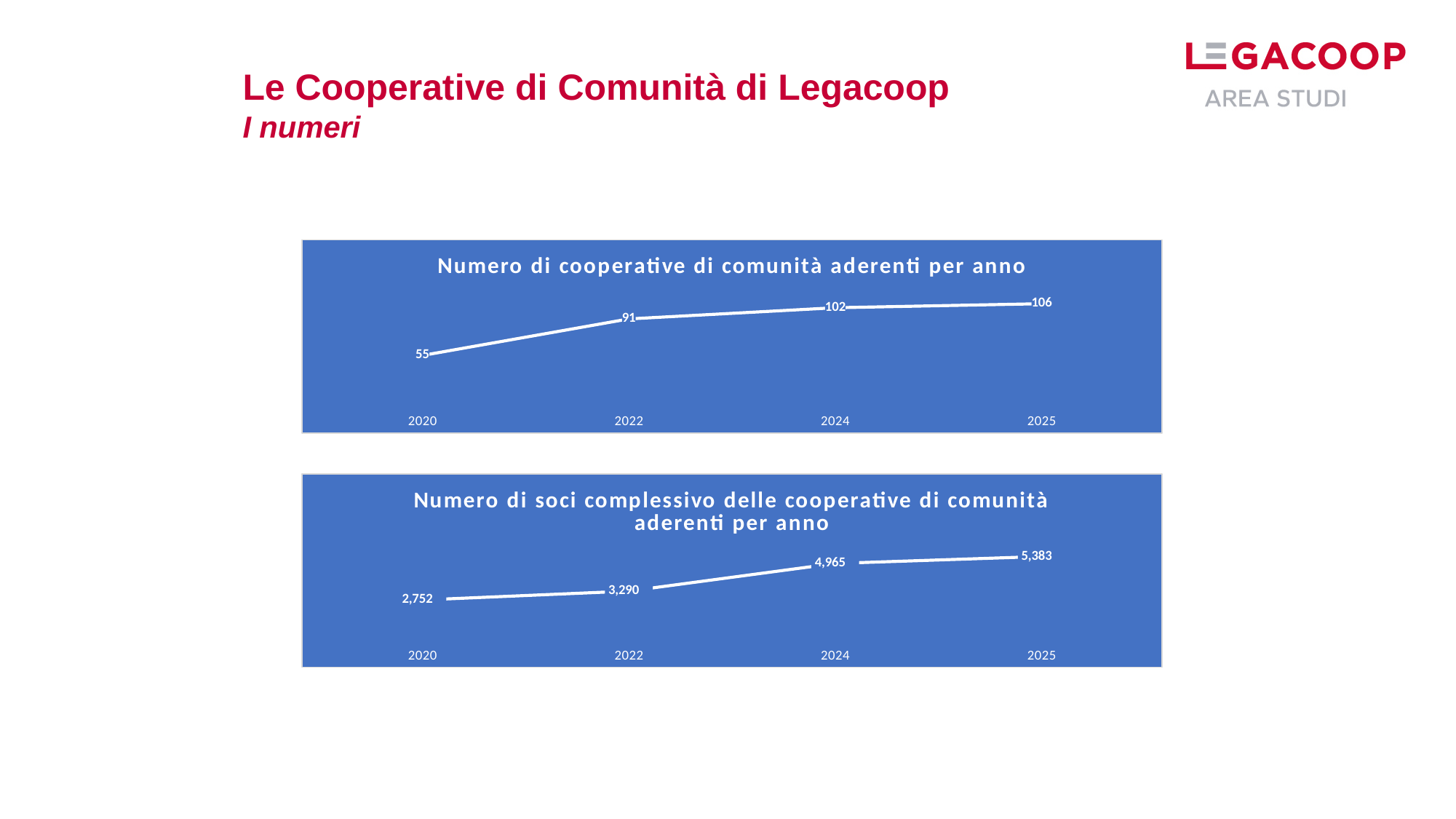
In the bottom chart 'Numero di soci complessivo delle cooperative di comunità aderenti per anno', what is the value for 2022? 3,290 In the top chart 'Numero di cooperative di comunità aderenti per anno', how many data points are plotted? 4 In the bottom chart 'Numero di soci complessivo delle cooperative di comunità aderenti per anno', what is the value for 2024? 4,965 What kind of chart is the top chart 'Numero di cooperative di comunità aderenti per anno'? line chart In the top chart 'Numero di cooperative di comunità aderenti per anno', what is the difference between the 2022 and 2020 values? 36 In the top chart 'Numero di cooperative di comunità aderenti per anno', which year has the lowest value? 2020 In the top chart 'Numero di cooperative di comunità aderenti per anno', do the values rise or fall from 2020 to 2025? rise In the top chart 'Numero di cooperative di comunità aderenti per anno', what is the value for 2020? 55 In the top chart 'Numero di cooperative di comunità aderenti per anno', what is the value for 2025? 106 In the bottom chart 'Numero di soci complessivo delle cooperative di comunità aderenti per anno', which is larger, the value for 2024 or the value for 2022? 2024 In the bottom chart 'Numero di soci complessivo delle cooperative di comunità aderenti per anno', what is the difference between the 2025 and 2020 values? 2,631 In the bottom chart 'Numero di soci complessivo delle cooperative di comunità aderenti per anno', which year has the highest value? 2025